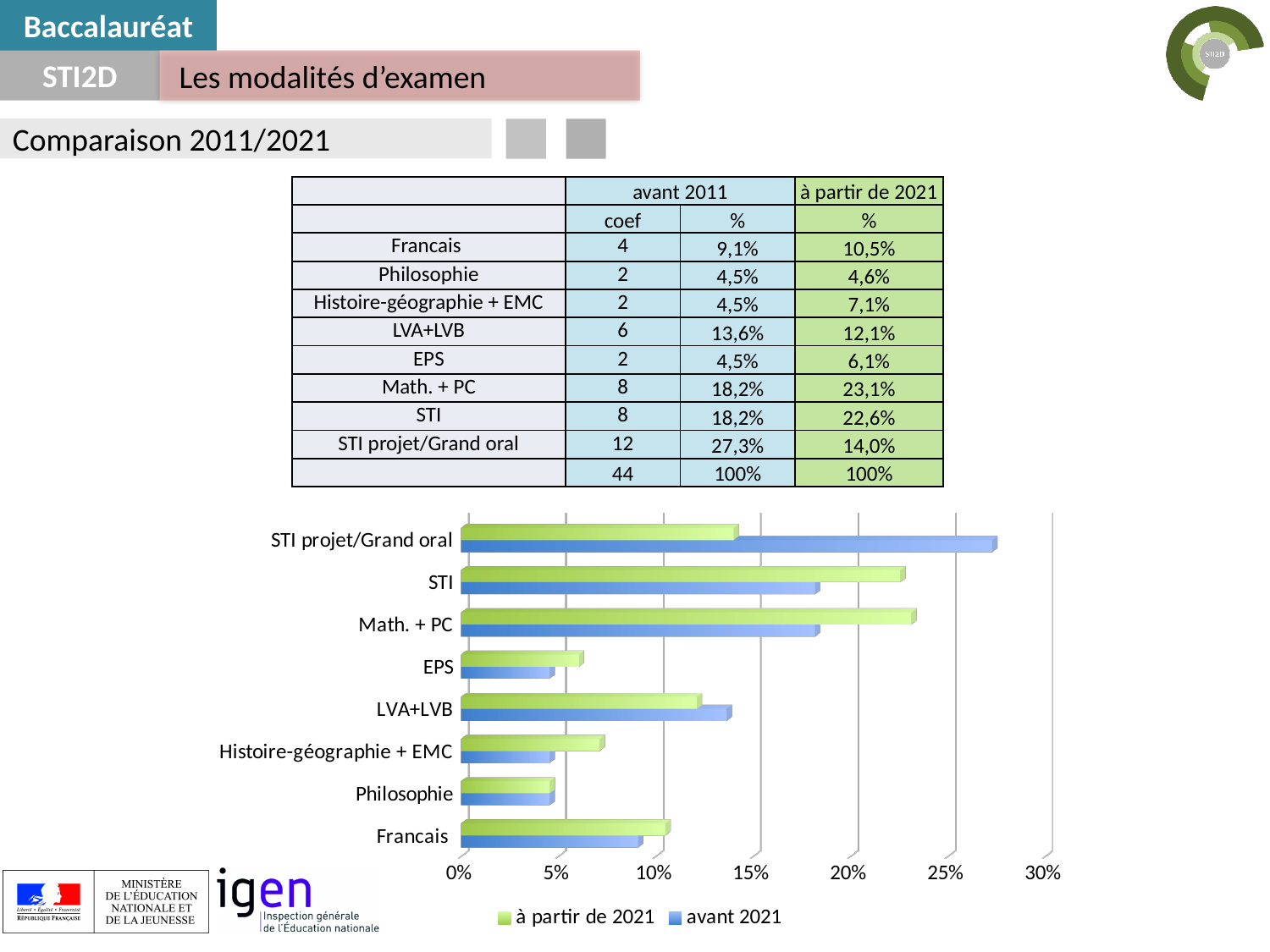
According to the table on the slide, what is the 'à partir de 2021' percentage for EPS? 6,1% Is the 'avant 2021' value for STI projet/Grand oral greater or less than 25%? greater How many series does the chart legend list? 2 For Histoire-géographie + EMC, which series has the larger value, 'avant 2021' or 'à partir de 2021'? à partir de 2021 Is the 'à partir de 2021' value for Math. + PC greater or less than 20%? greater Which colour represents the 'à partir de 2021' series in the chart? green Which category has the lowest value for the 'à partir de 2021' series in the chart? Philosophie What kind of chart is shown on the slide? bar chart Is the 'avant 2021' value for Francais greater or less than 10%? less How many categories are plotted on the chart? 8 Which category has the highest value for the 'avant 2021' series in the chart? STI projet/Grand oral For LVA+LVB, which series has the larger value, 'avant 2021' or 'à partir de 2021'? avant 2021